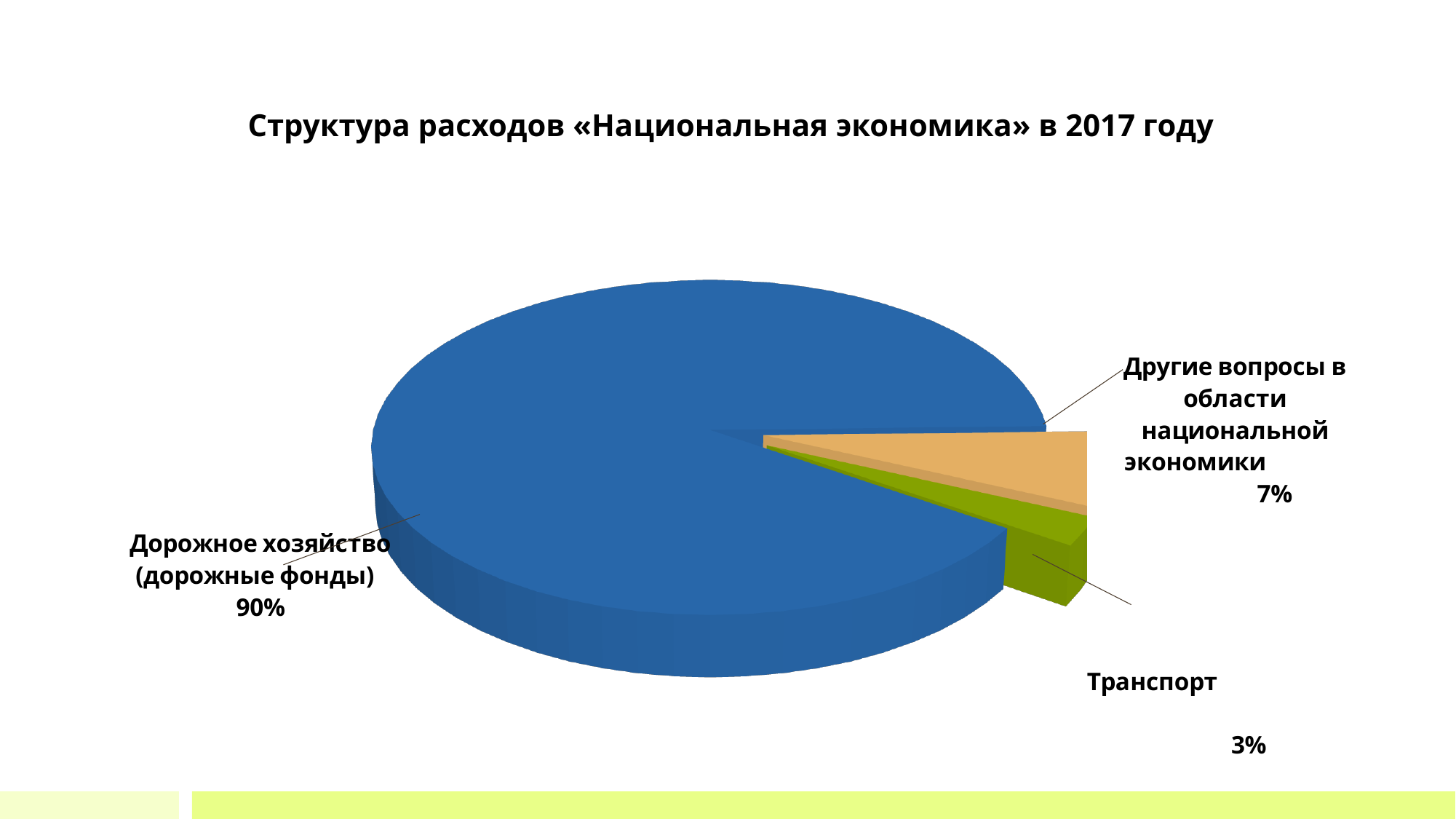
What kind of chart is shown on the slide? pie chart Which is larger, the share for Транспорт or the share for Другие вопросы в области национальной экономики? Другие вопросы в области национальной экономики What is the title of the chart? Структура расходов «Национальная экономика» в 2017 году Which category has the smallest slice of the pie? Транспорт What is the difference in percentage points between Другие вопросы в области национальной экономики and Транспорт? 4% What share of the pie is labelled for Другие вопросы в области национальной экономики? 7% What is the difference in percentage points between Дорожное хозяйство (дорожные фонды) and Другие вопросы в области национальной экономики? 83% What colour is the slice for Дорожное хозяйство (дорожные фонды)? blue What share of the pie is labelled for Дорожное хозяйство (дорожные фонды)? 90% How many slices does the pie chart have? 3 What share of the pie is labelled for Транспорт? 3% Which category has the largest slice of the pie? Дорожное хозяйство (дорожные фонды)